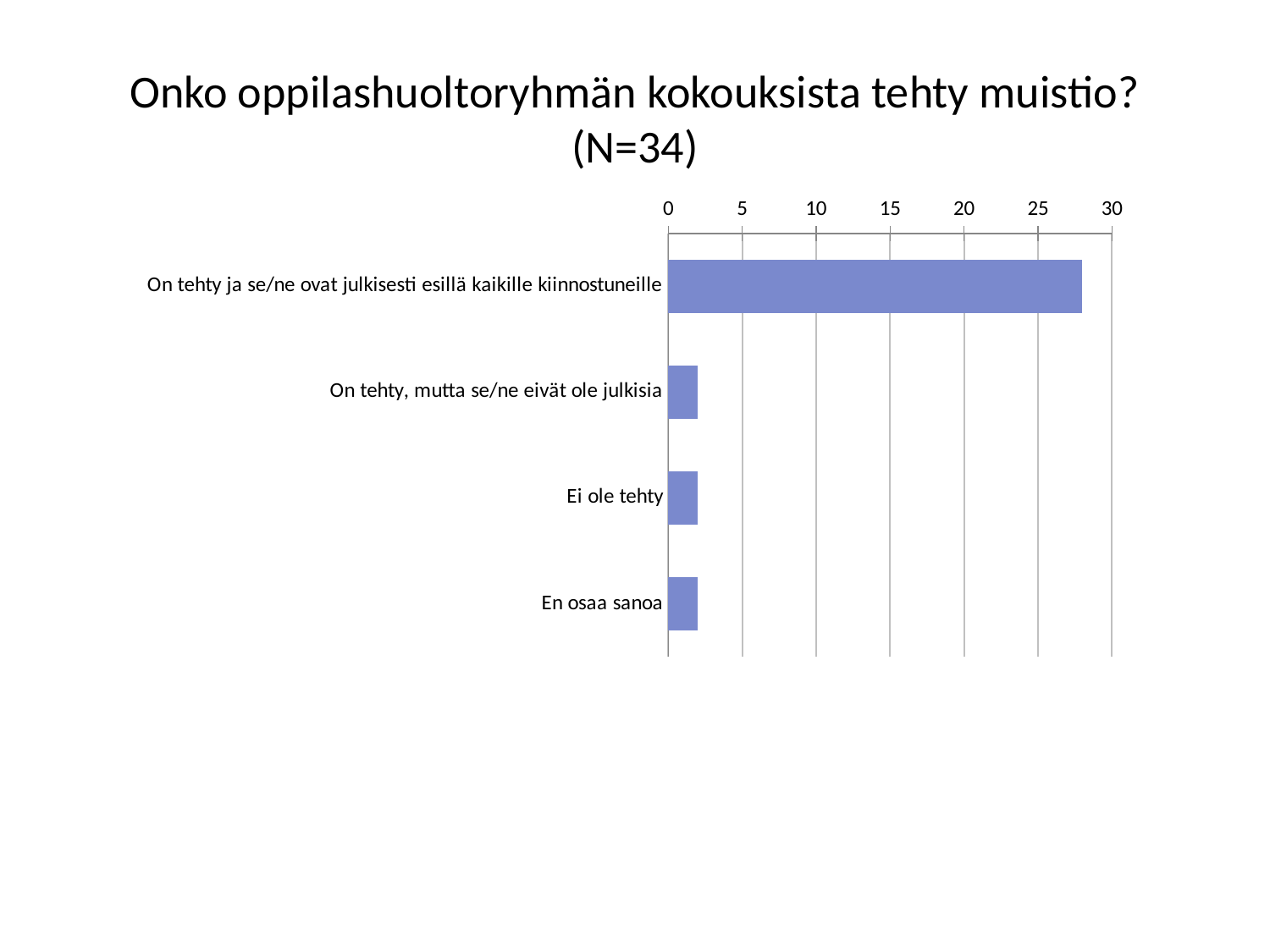
What is the title of the chart on the slide? Onko oppilashuoltoryhmän kokouksista tehty muistio? (N=34) What is the highest value shown on the chart's value axis? 30 How many categories are shown in the chart? 4 Is the value for "On tehty, mutta se/ne eivät ole julkisia" greater or less than 10? less Which category has the highest value? On tehty ja se/ne ovat julkisesti esillä kaikille kiinnostuneille Is the value for "On tehty ja se/ne ovat julkisesti esillä kaikille kiinnostuneille" greater or less than 30? less Is the value for "Ei ole tehty" greater or less than 5? less What kind of chart is shown on the slide? bar chart Which is larger: the value for "On tehty ja se/ne ovat julkisesti esillä kaikille kiinnostuneille" or the value for "Ei ole tehty"? On tehty ja se/ne ovat julkisesti esillä kaikille kiinnostuneille Which is larger: the value for "En osaa sanoa" or the value for "On tehty ja se/ne ovat julkisesti esillä kaikille kiinnostuneille"? On tehty ja se/ne ovat julkisesti esillä kaikille kiinnostuneille